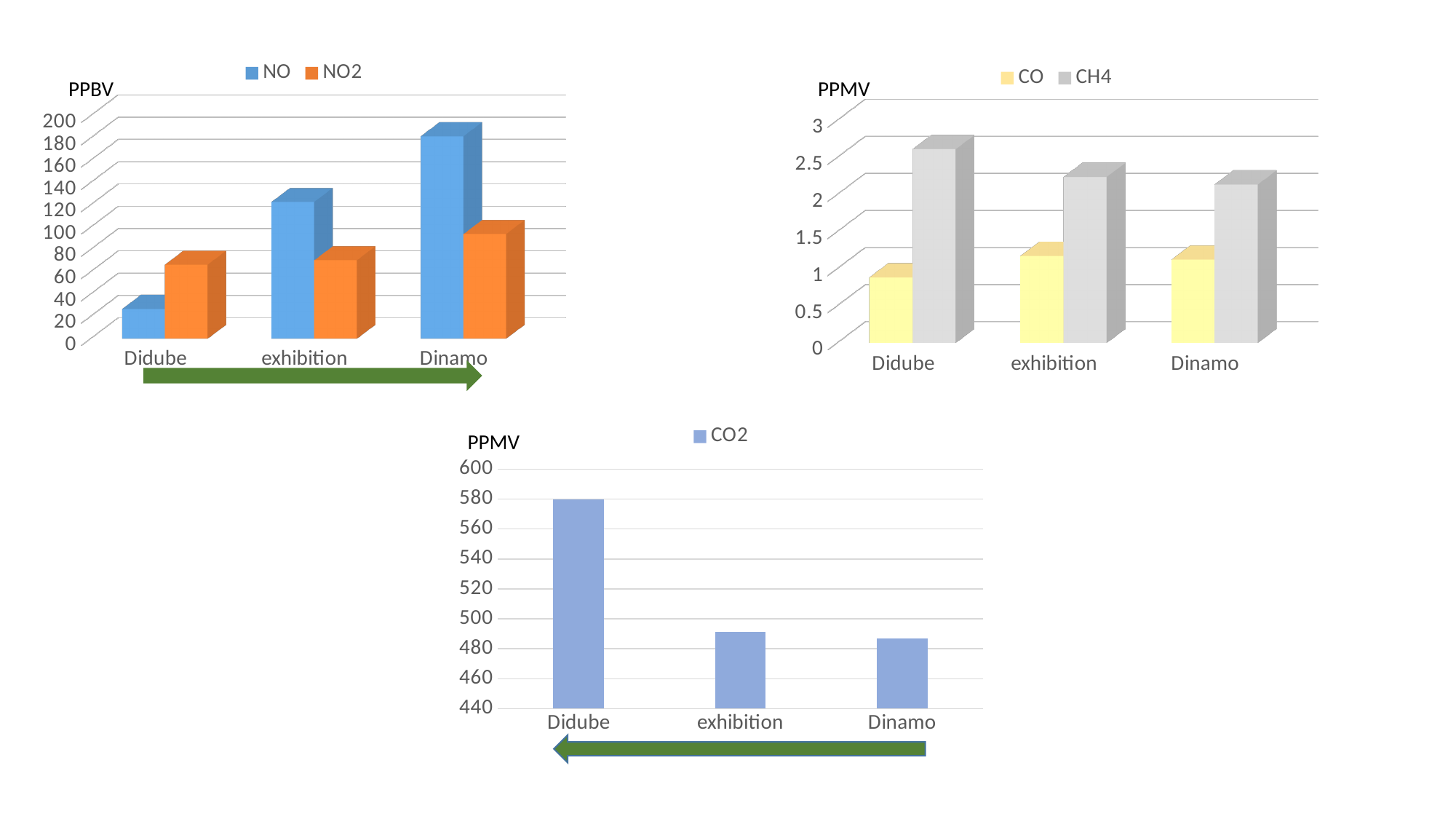
In the top-right chart (CO and CH4), which category has the highest CH4 value? Didube In the top-left chart (NO and NO2), which is larger for Didube, NO or NO2? NO2 In the top-left chart (NO and NO2), which category has the highest NO value? Dinamo In the bottom chart (CO2), which category has the highest value? Didube How many series does the legend of the top-left chart (NO and NO2) list? 2 What kind of chart is the bottom chart (CO2)? bar chart In the bottom chart (CO2), is the value for Didube greater or less than 560? greater How many categories are shown on the x axis of the bottom chart (CO2)? 3 In the bottom chart (CO2), do the values rise or fall from Didube to Dinamo along the x axis? fall In the top-left chart (NO and NO2), is the NO value for Dinamo greater or less than 140? greater What unit label is shown on the vertical axis of the top-right chart (CO and CH4)? PPMV In the bottom chart (CO2), is the value for exhibition greater or less than 500? less